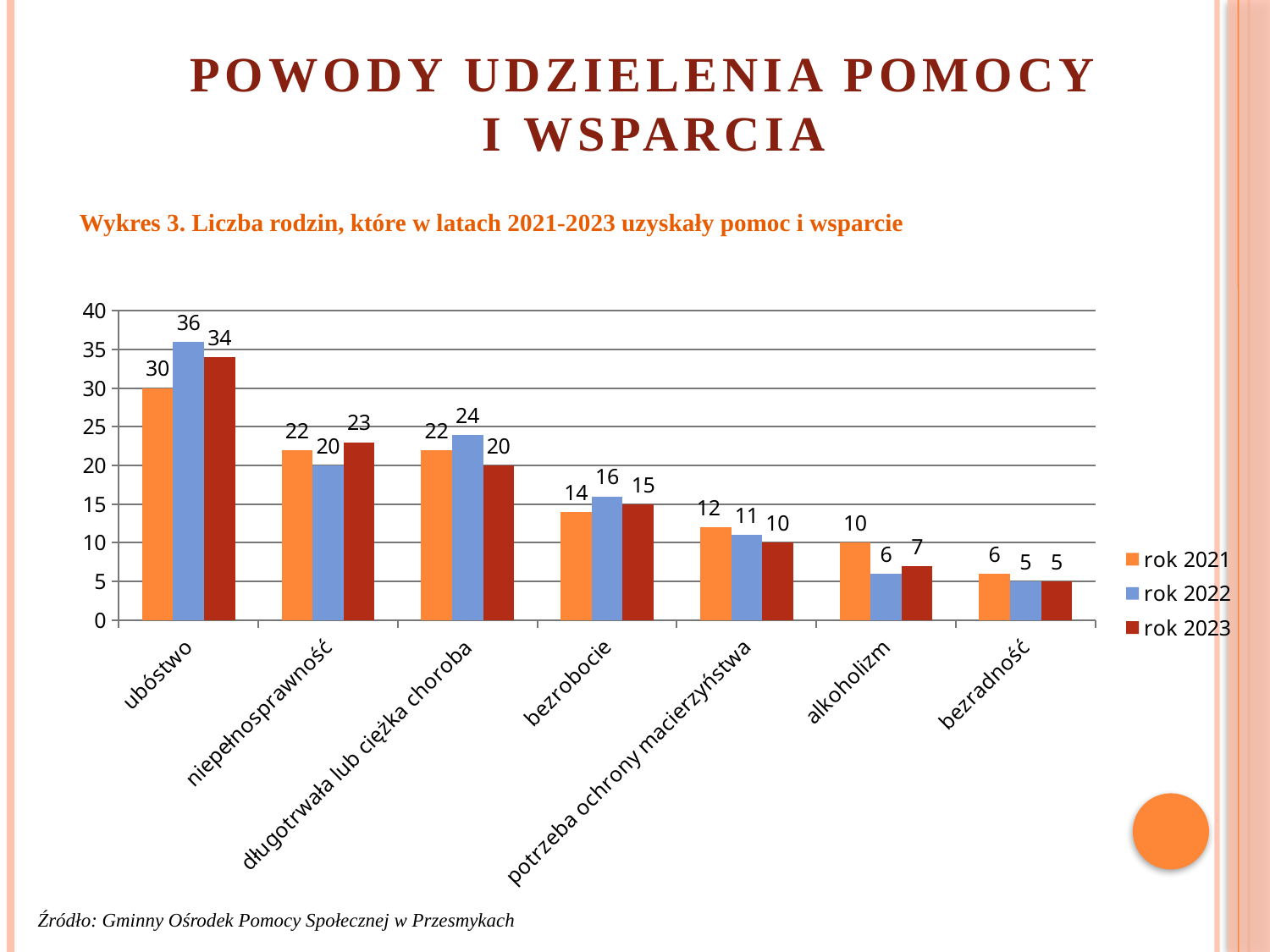
What is the value for bezrobocie in rok 2023? 15 What is the value for alkoholizm in rok 2021? 10 What kind of chart is shown on the slide? bar chart How many series does the legend list? 3 Do the rok 2021 values rise or fall from ubóstwo to bezradność along the x axis? fall Which category has the highest value in rok 2023? ubóstwo What is the title of the chart (Wykres 3)? Liczba rodzin, które w latach 2021-2023 uzyskały pomoc i wsparcie What is the value for ubóstwo in rok 2022? 36 What is the difference between the rok 2022 and rok 2023 values for ubóstwo? 2 Which category has the lowest value in rok 2021? bezradność How many categories are shown on the x axis? 7 Which is larger for niepełnosprawność: the rok 2021 value or the rok 2022 value? rok 2021